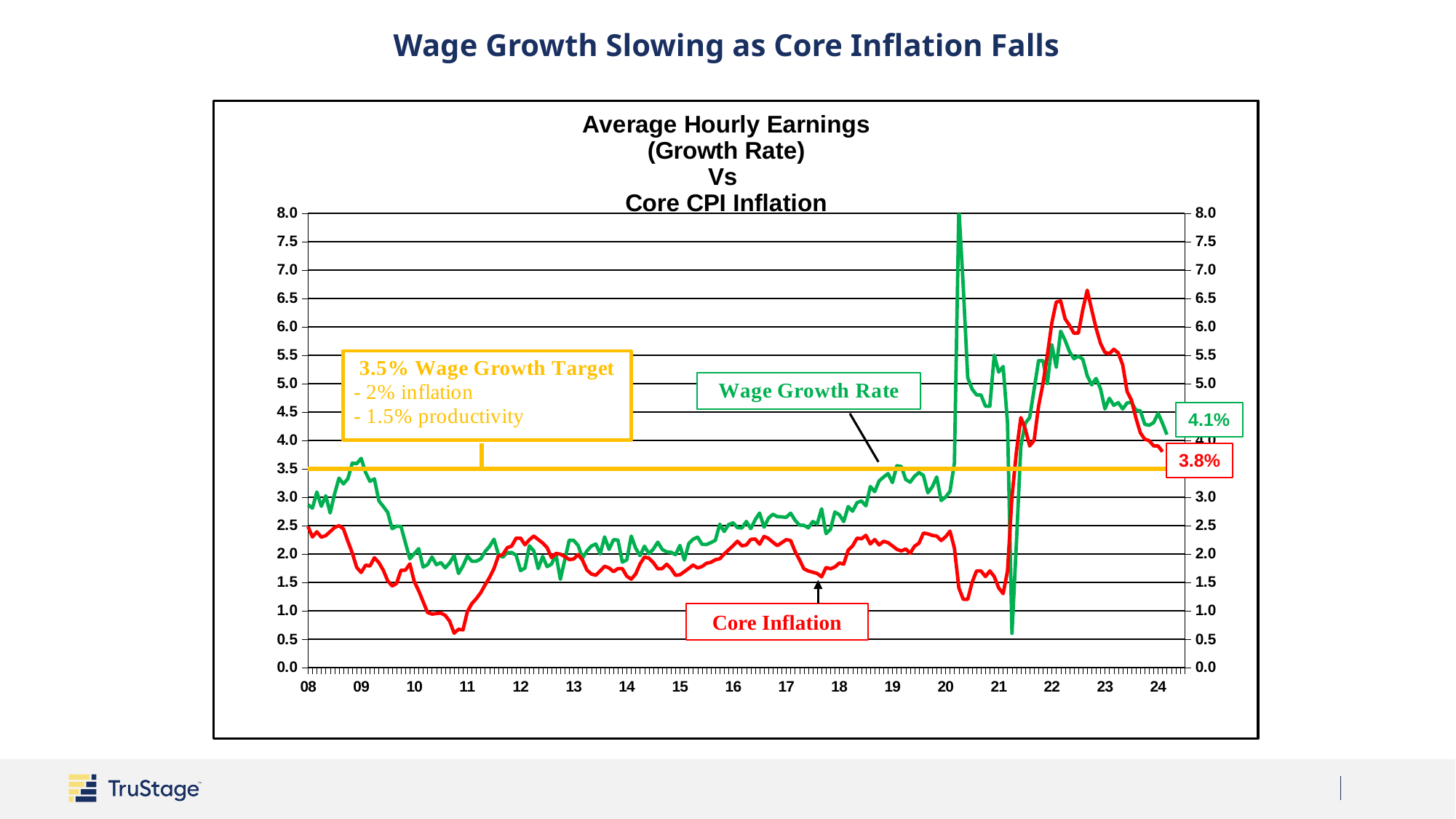
Is the peak of the Wage Growth Rate series around 2020 greater or less than 7.5? greater What is the difference between the latest labelled Wage Growth Rate (4.1%) and the latest labelled Core Inflation (3.8%)? 0.3% At the end of the chart, which is larger: the Wage Growth Rate or Core Inflation? Wage Growth Rate What kind of chart is shown on the slide? line chart Is the peak of the Core Inflation series around 2022 greater or less than 6.0? greater What is the latest labelled value of the Wage Growth Rate series? 4.1% Does the Wage Growth Rate series rise or fall from 2022 to 2024? fall What wage growth target is marked by the horizontal yellow line? 3.5% How many data series are plotted on the chart? 3 What is the latest labelled value of the Core Inflation series? 3.8% Is the lowest point of the Core Inflation series around 2011 greater or less than 1.0? less Which series reaches the highest value anywhere on the chart? Wage Growth Rate